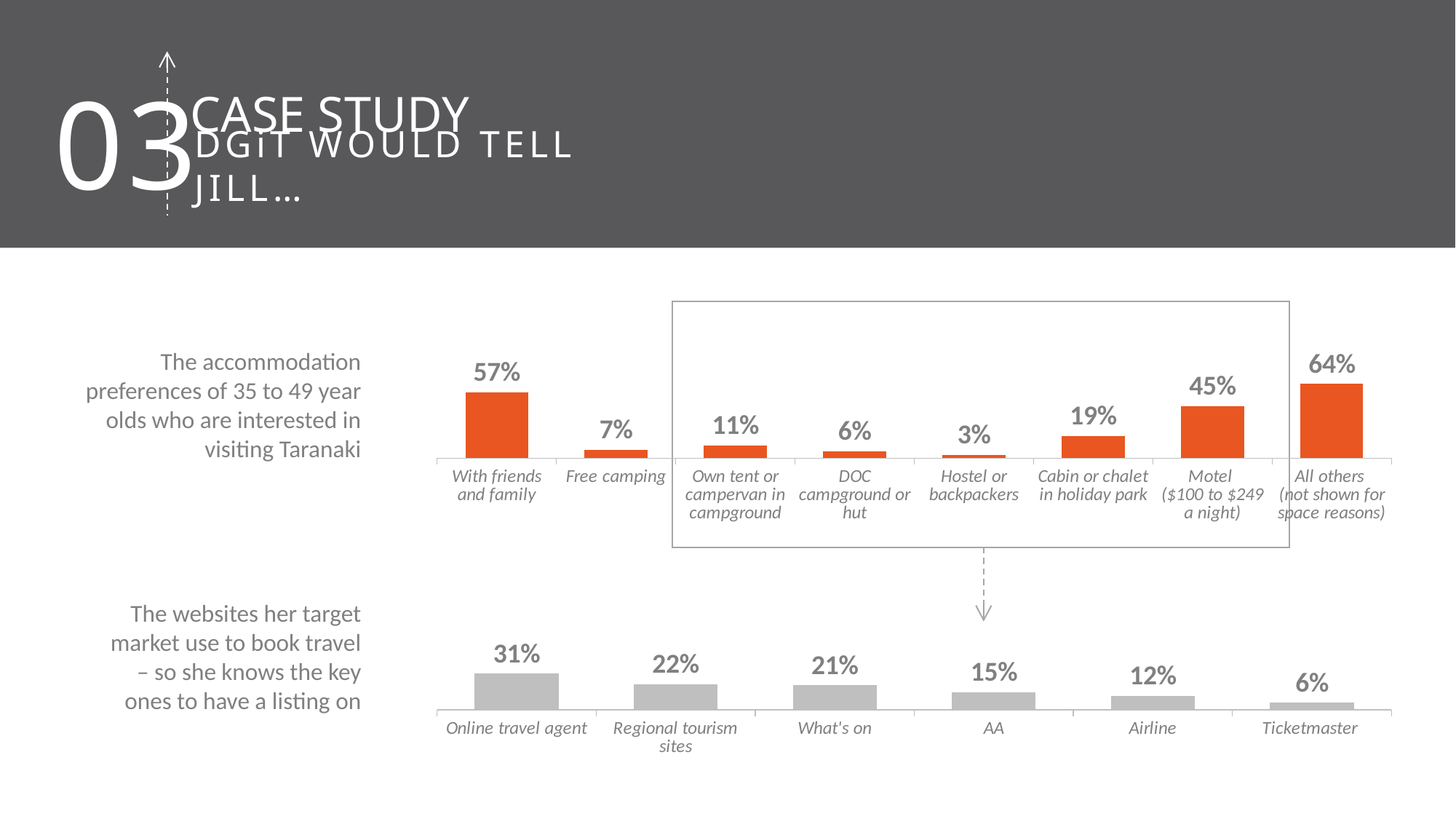
How many categories are shown in the top chart (accommodation preferences)? 8 In the top chart (accommodation preferences), what is the value for Motel ($100 to $249 a night)? 45% In the bottom chart (websites used to book travel), what is the difference between AA and Ticketmaster? 9% In the top chart (accommodation preferences), which category has the highest value? All others (not shown for space reasons) What type of chart is the bottom chart (websites used to book travel)? Bar chart In the bottom chart (websites used to book travel), what is the value for Regional tourism sites? 22% In the top chart (accommodation preferences), what is the value for Hostel or backpackers? 3% How many categories are shown in the bottom chart (websites used to book travel)? 6 In the bottom chart (websites used to book travel), which category has the highest value? Online travel agent In the top chart (accommodation preferences), what is the difference between With friends and family and Free camping? 50% In the top chart (accommodation preferences), which is larger: Cabin or chalet in holiday park or Own tent or campervan in campground? Cabin or chalet in holiday park In the top chart (accommodation preferences), which category has the lowest value? Hostel or backpackers